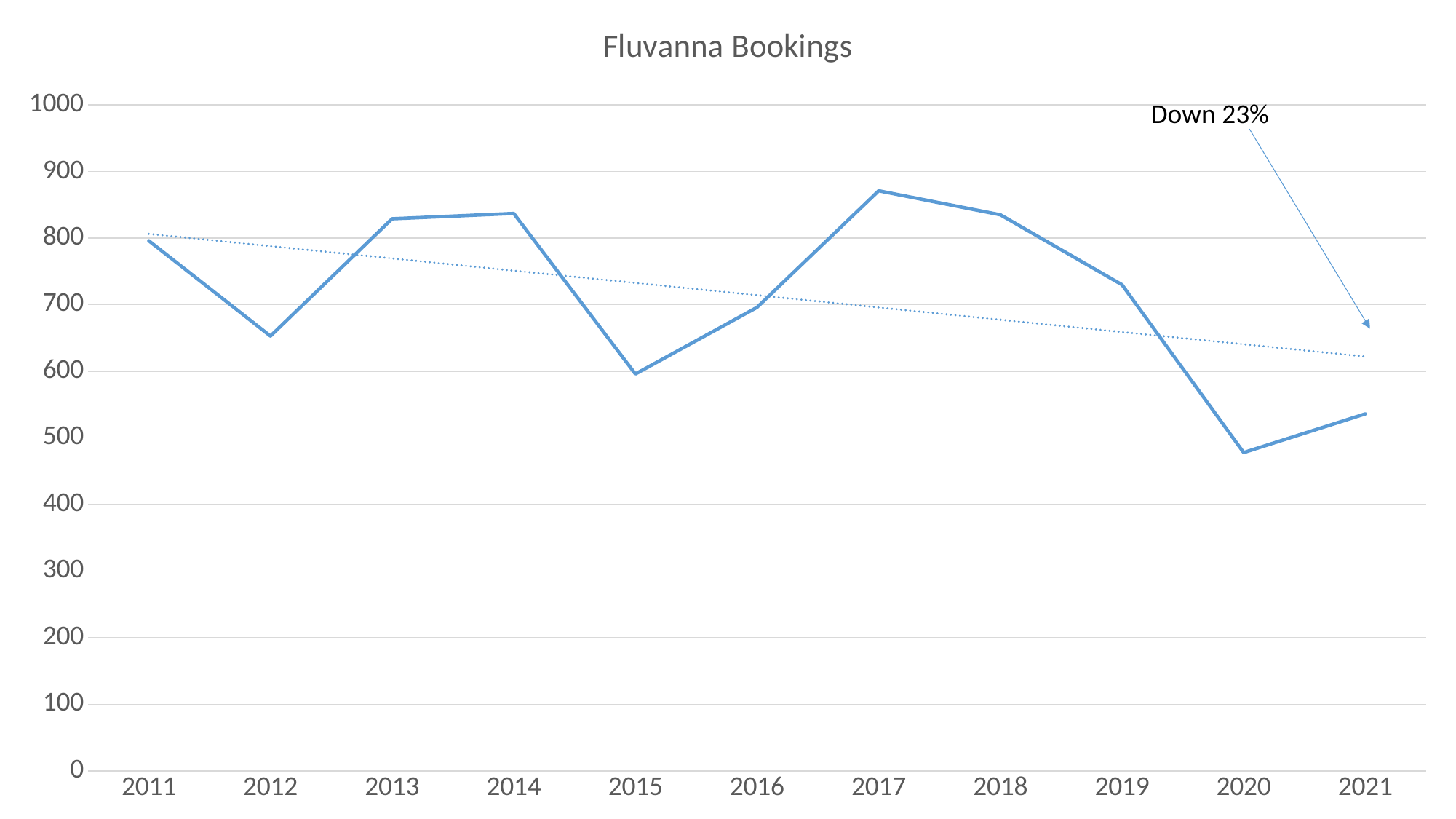
Is the value for 2012 greater or less than 700? less Which year has the highest number of bookings? 2017 Is the value for 2015 greater or less than 500? greater Is the value for 2020 greater or less than 500? less What does the text annotation with the arrow pointing to 2021 say? Down 23% According to the dotted trendline, do bookings rise or fall overall from 2011 to 2021? Fall What type of chart is shown on the slide? Line chart What is the title of the chart? Fluvanna Bookings How many years are plotted along the x axis? 11 Which year has the lowest number of bookings? 2020 Which year has more bookings, 2013 or 2012? 2013